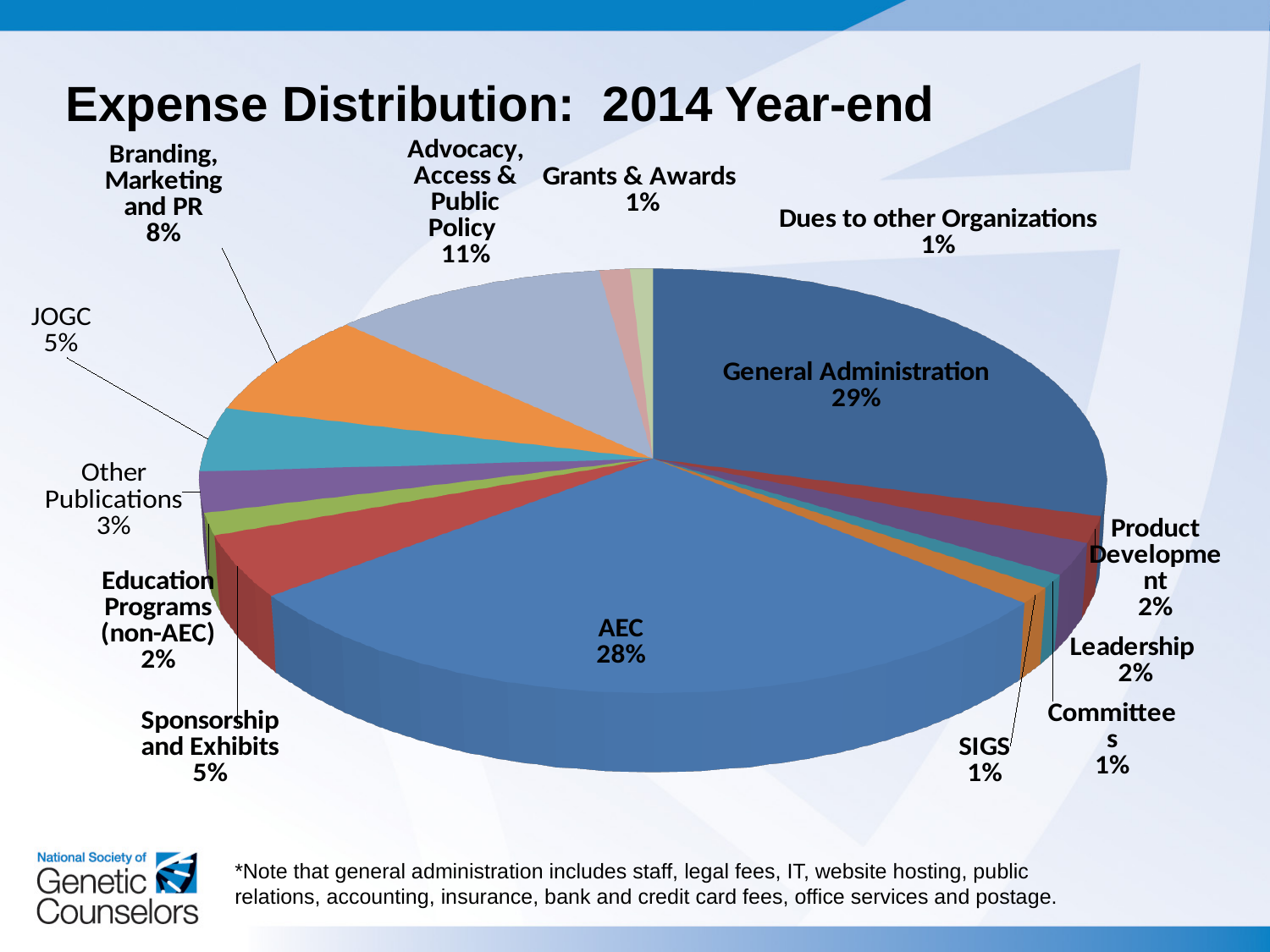
What percentage is shown for Product Development? 2% What kind of chart is shown on the slide? Pie chart Which is larger, the share for JOGC or the share for Other Publications? JOGC Which category has the largest share of expenses? General Administration What percentage is shown for Sponsorship and Exhibits? 5% How many categories are shown in the pie chart? 14 What is the difference in percentage points between General Administration and AEC? 1% What percentage is shown for Branding, Marketing and PR? 8% What is the title of the chart? Expense Distribution: 2014 Year-end What percentage is shown for Advocacy, Access & Public Policy? 11% What share of expenses is AEC? 28% What share of expenses is General Administration? 29%